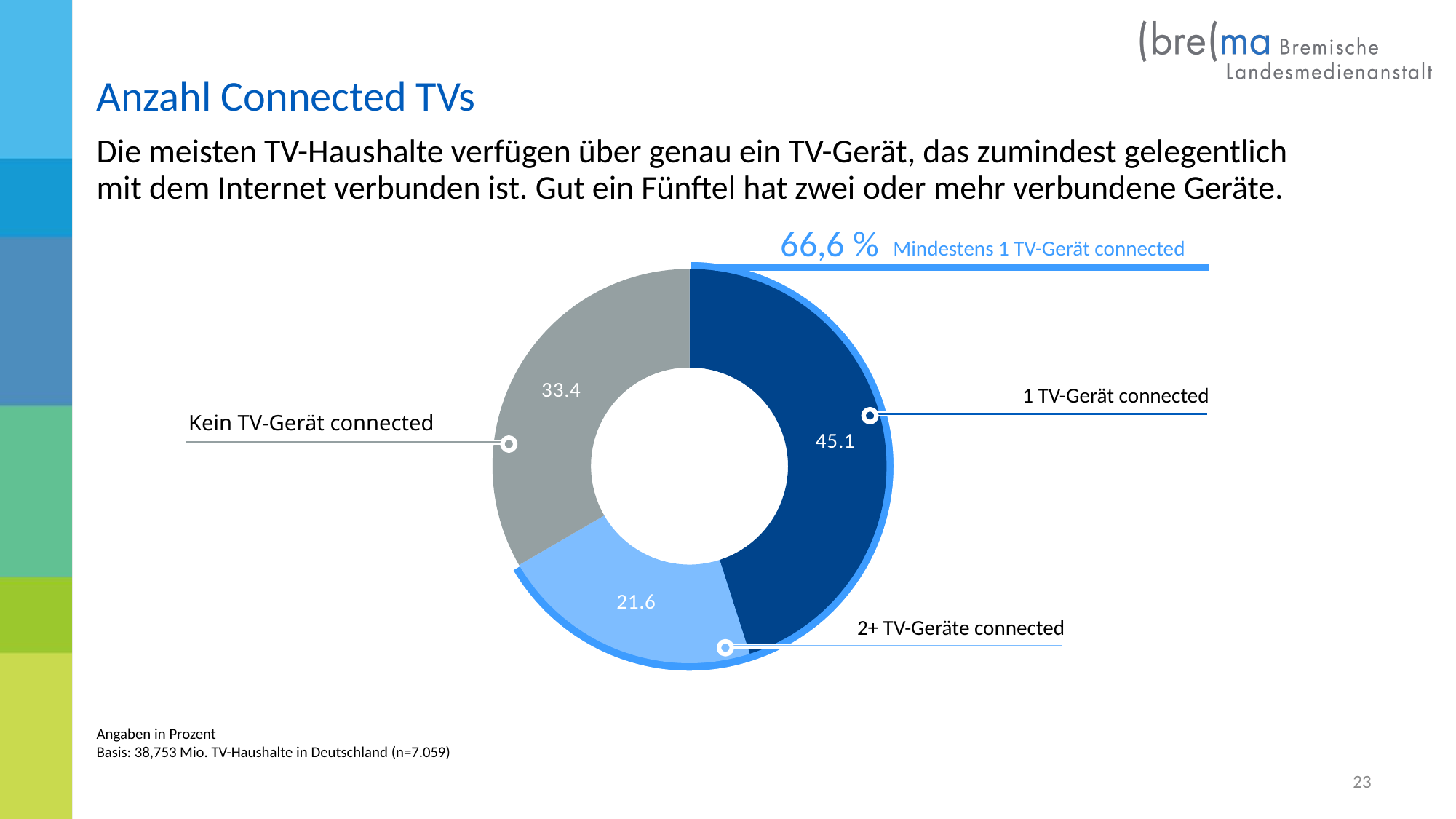
What is the difference between the values for "Kein TV-Gerät connected" and "2+ TV-Geräte connected"? 11.8 What kind of chart is shown on the slide? Pie chart (donut) Which category has the largest share of the chart? 1 TV-Gerät connected What is the difference between the values for "1 TV-Gerät connected" and "Kein TV-Gerät connected"? 11.7 What is the title of the slide containing the chart? Anzahl Connected TVs What is the value for "Kein TV-Gerät connected"? 33.4 How many categories does the chart show? 3 Which category has the smallest share of the chart? 2+ TV-Geräte connected What is the value for "1 TV-Gerät connected"? 45.1 What is the value for "2+ TV-Geräte connected"? 21.6 What percentage is given on the slide for "Mindestens 1 TV-Gerät connected"? 66,6 % Which is larger, the value for "Kein TV-Gerät connected" or the value for "2+ TV-Geräte connected"? Kein TV-Gerät connected